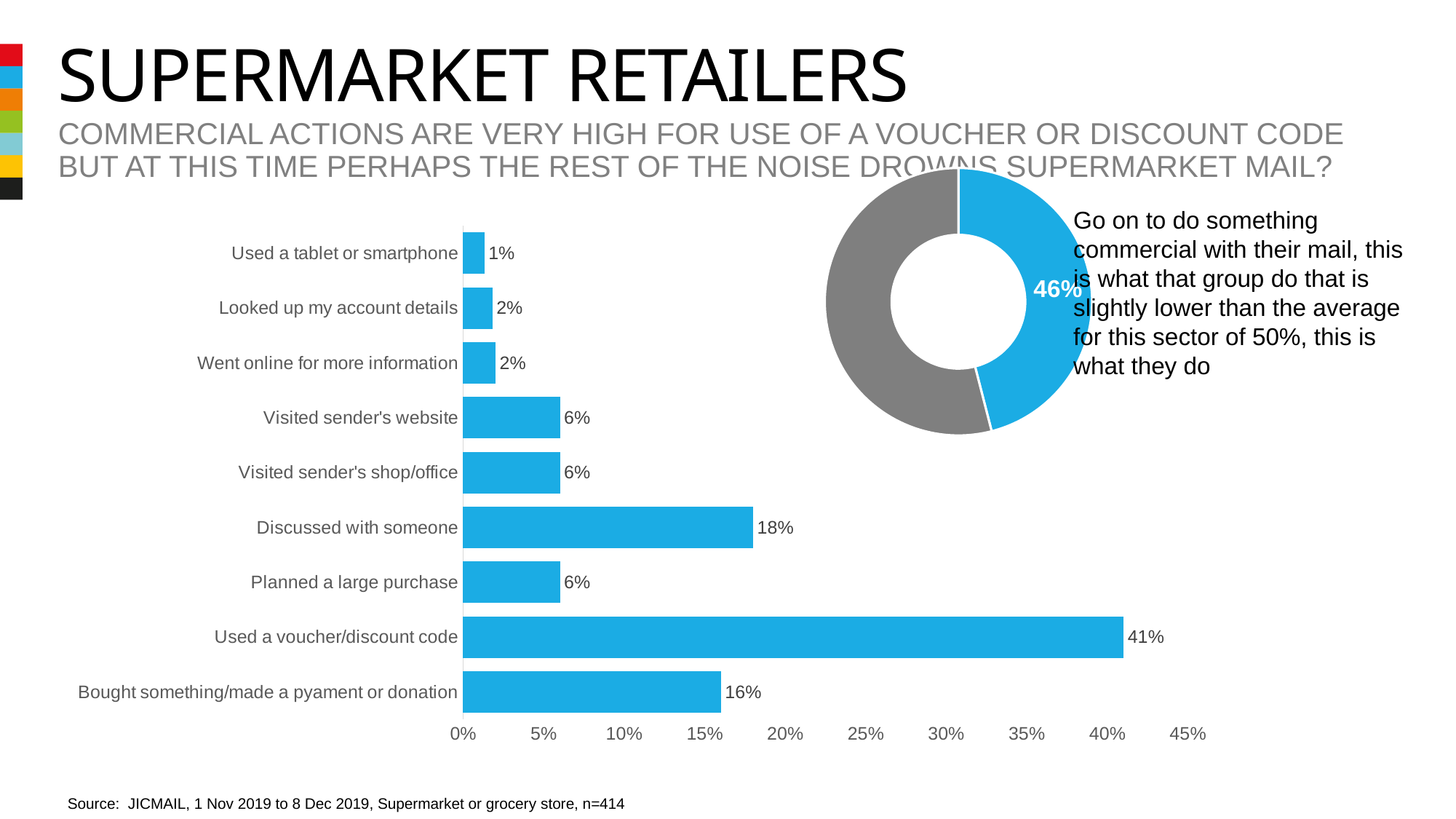
In the bar chart, what is the difference between 'Used a voucher/discount code' and 'Discussed with someone'? 23% In the bar chart, which category has the highest value? Used a voucher/discount code In the bar chart, what is the value for 'Used a voucher/discount code'? 41% In the bar chart, what is the value for 'Bought something/made a pyament or donation'? 16% What kind of chart is the chart on the left of the slide? bar chart In the bar chart, which category has the lowest value? Used a tablet or smartphone In the bar chart, is the value for 'Used a voucher/discount code' greater or less than 35%? greater In the bar chart, which is larger: 'Discussed with someone' or 'Bought something/made a pyament or donation'? Discussed with someone What kind of chart is the chart on the right of the slide? doughnut chart In the doughnut chart on the right, what percentage is shown for the blue segment? 46% In the bar chart, what is the value for 'Discussed with someone'? 18% How many categories does the bar chart show? 9